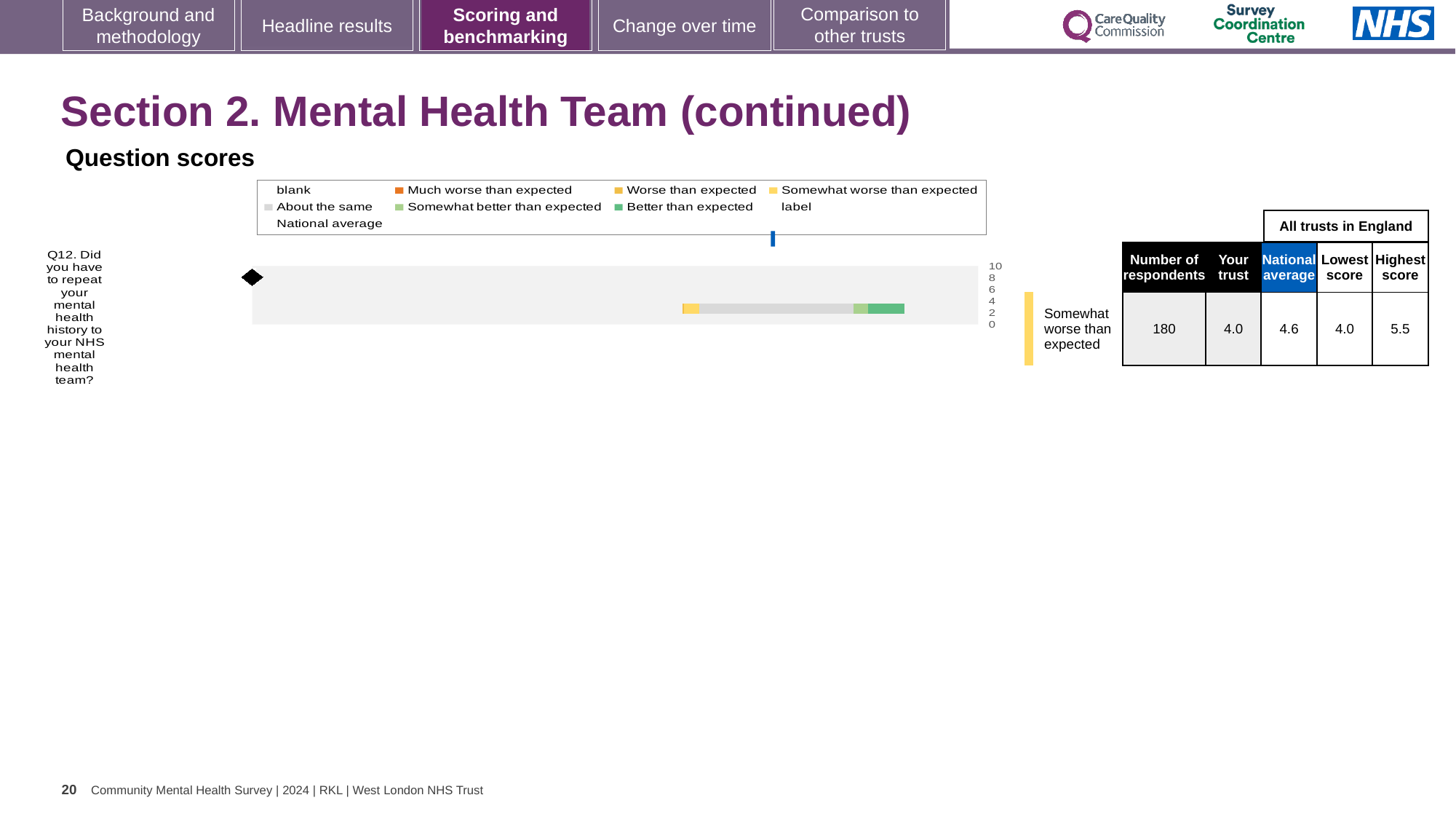
In the table beside the chart, what is the 'Your trust' score for Q12? 4.0 In the table beside the chart, what is the national average score for Q12? 4.6 What is the difference between the highest score and the lowest score for Q12 in the table? 1.5 In the table beside the chart, what is the number of respondents for Q12? 180 What kind of chart is shown under 'Question scores'? bar chart In the chart legend, what colour represents 'Better than expected'? green Which is larger for Q12, the 'Your trust' score or the national average? National average How many survey questions are plotted in the Question scores chart? 1 In the table beside the chart, what is the lowest score among all trusts in England for Q12? 4.0 What benchmark rating label is shown next to the Q12 bar? Somewhat worse than expected In the table beside the chart, what is the highest score among all trusts in England for Q12? 5.5 Which question is plotted in the Question scores chart? Q12. Did you have to repeat your mental health history to your NHS mental health team?